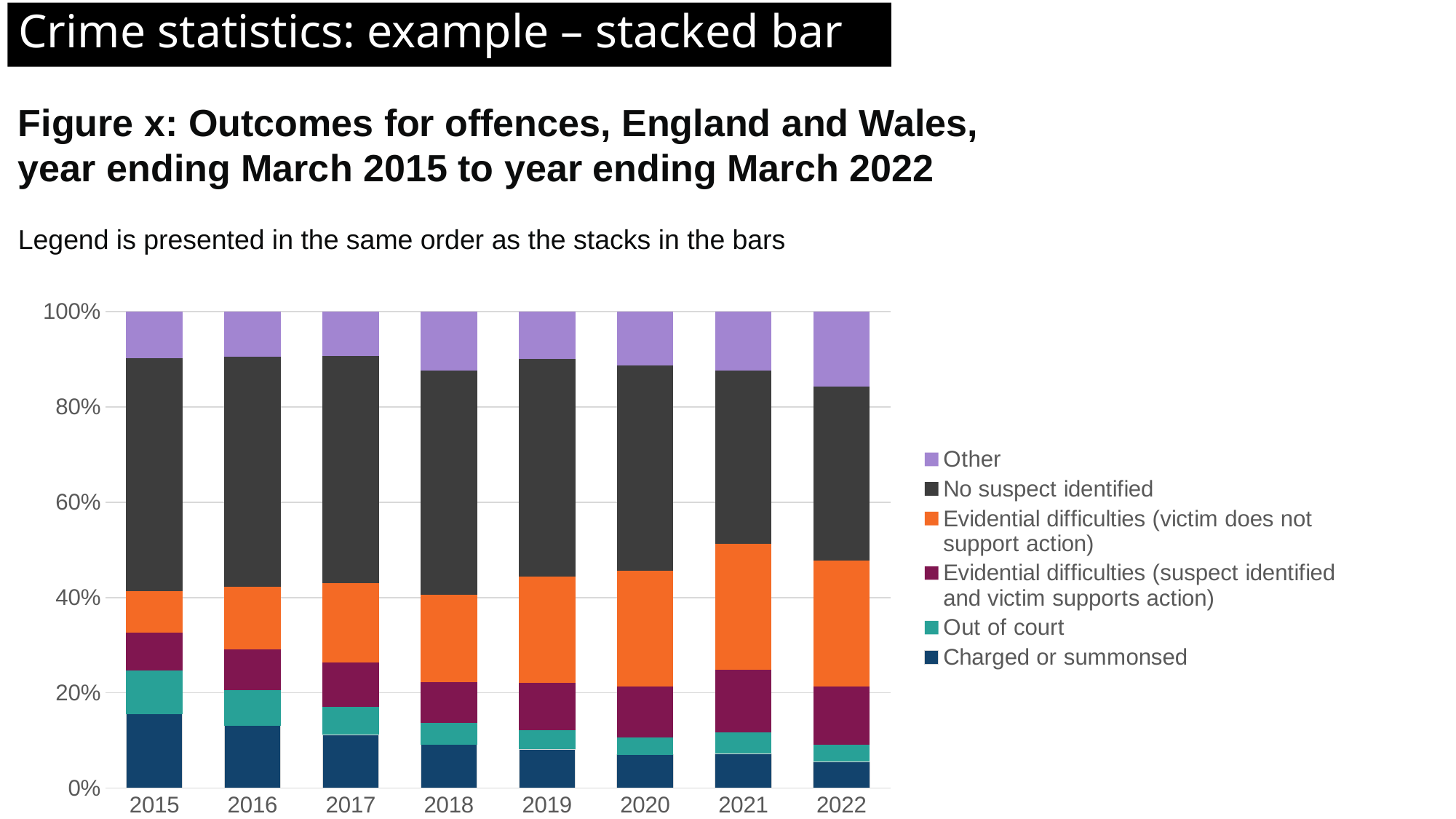
In which year is the 'Charged or summonsed' share the lowest? 2022 Which year has the larger 'Out of court' share, 2015 or 2022? 2015 How many series does the chart's legend list? 6 How many years are shown along the x axis of the chart? 8 What is the total of each stacked bar in the chart? 100% Is the 'Charged or summonsed' share in 2015 greater or less than 20%? less What kind of chart is shown on the slide? Stacked bar chart Does the 'Charged or summonsed' share rise or fall from 2015 to 2022? Fall Is the 'Charged or summonsed' share in 2022 greater or less than 10%? less In which year is the 'Other' share the largest? 2022 In which year is the 'Charged or summonsed' share the highest? 2015 Which legend entry is shown in orange? Evidential difficulties (victim does not support action)